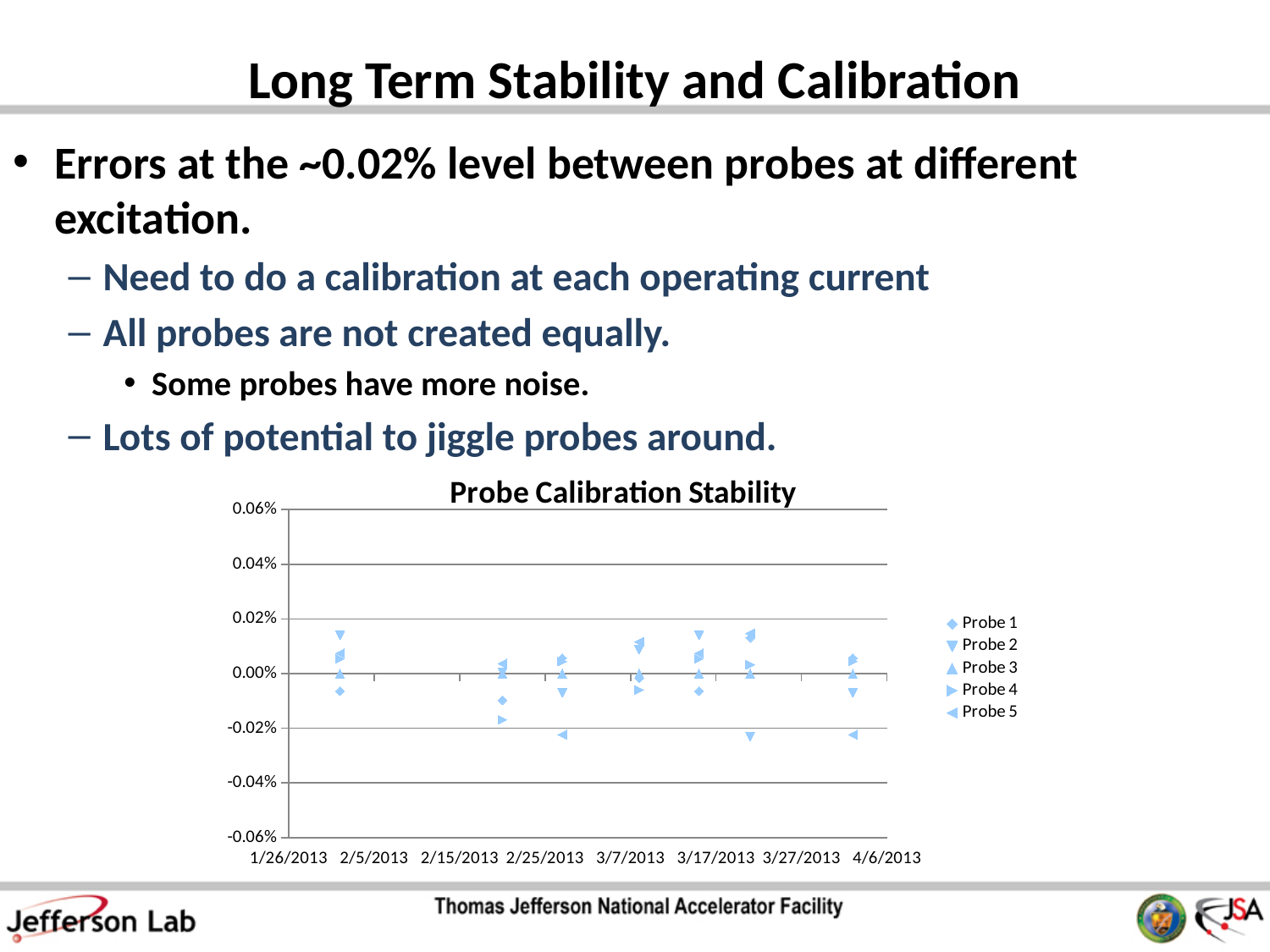
What is the first date label on the chart's x axis? 1/26/2013 Is the lowest plotted value in the chart greater or less than -0.02%? less What is the title of the chart? Probe Calibration Stability What is the last date label on the chart's x axis? 4/6/2013 What kind of chart is shown on the slide? scatter chart Is the highest plotted value in the chart greater or less than 0.02%? less How many date labels are shown along the chart's x axis? 8 How many series does the chart's legend list? 5 Is the lowest plotted value in the chart greater or less than -0.04%? greater